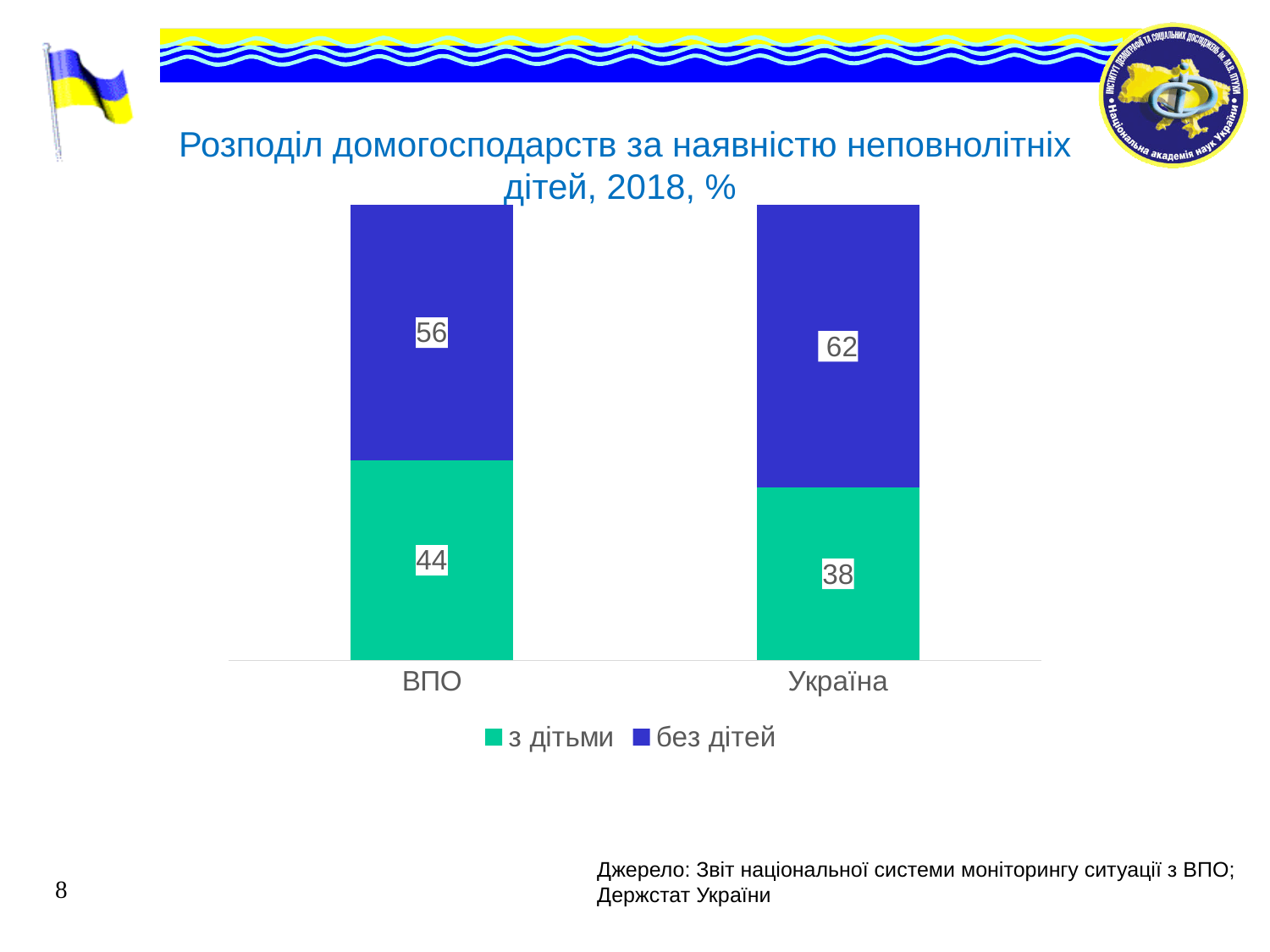
How many categories are shown on the x axis? 2 How many series does the legend list? 2 Which category has the higher value for 'з дітьми', ВПО or Україна? ВПО What is the value for 'без дітей' in the Україна bar? 62 What is the difference between the 'з дітьми' values for ВПО and Україна? 6 What kind of chart is shown on the slide? Stacked bar chart What is the difference between the 'без дітей' values for Україна and ВПО? 6 What is the value for 'з дітьми' in the Україна bar? 38 What is the value for 'без дітей' in the ВПО bar? 56 What is the value for 'з дітьми' in the ВПО bar? 44 Which category has the lower value for 'без дітей'? ВПО What is the total of the stacked bar for ВПО? 100